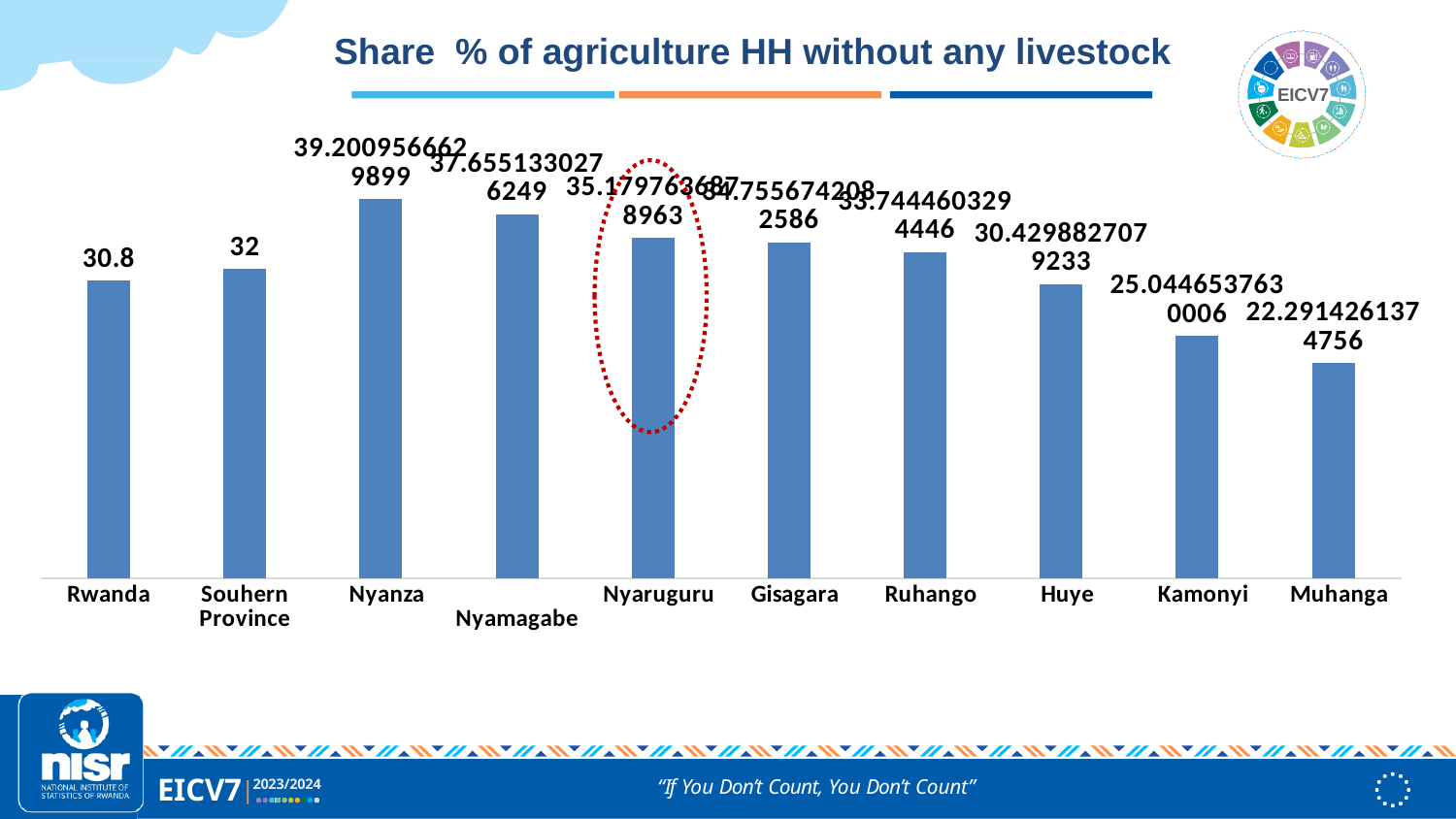
Which category has the highest value? Nyanza What is the value shown for Rwanda? 30.8 Which has a larger value, Huye or Kamonyi? Huye What is the difference between the values for Souhern Province and Rwanda? 1.2 What is the title of the chart? Share % of agriculture HH without any livestock What is the value shown for Muhanga? 22.2914261374756 What is the value shown for Souhern Province? 32 Which category's bar is highlighted with a red dotted circle? Nyaruguru Which category has the lowest value? Muhanga What type of chart is shown on the slide? bar chart How many categories are plotted in the chart? 10 What is the value shown for Huye? 30.4298827079233